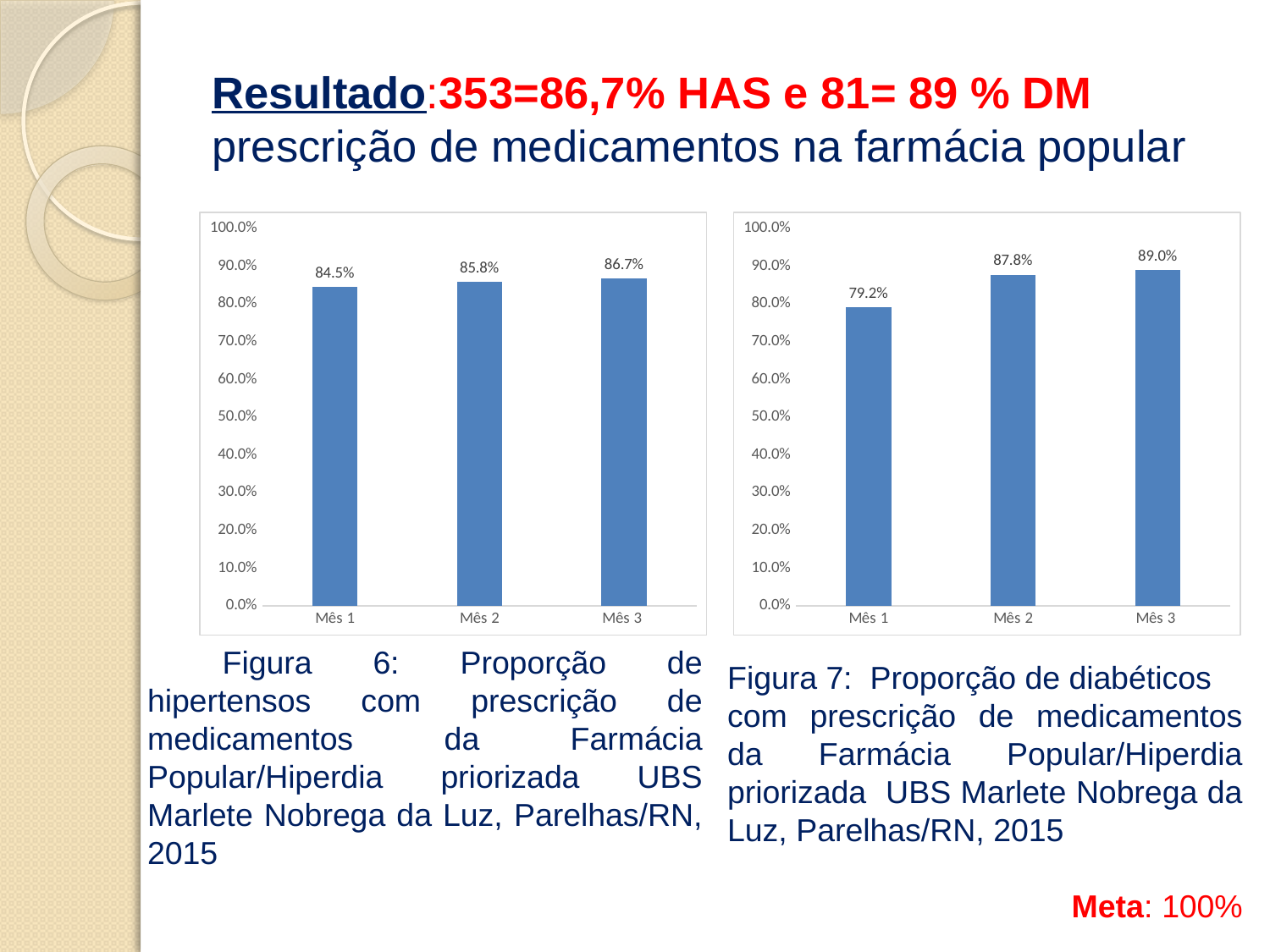
What kind of chart is the right chart (Figura 7, diabéticos)? bar chart In the left chart (Figura 6, hipertensos), what is the difference between Mês 3 and Mês 1? 2.2% In the right chart (Figura 7, diabéticos), what is the value for Mês 2? 87.8% In the right chart (Figura 7, diabéticos), what is the difference between Mês 2 and Mês 1? 8.6% In the left chart (Figura 6, hipertensos), what is the value for Mês 1? 84.5% In the left chart (Figura 6, hipertensos), do the values rise or fall from Mês 1 to Mês 3? rise In the right chart (Figura 7, diabéticos), which month has the lowest value? Mês 1 In the right chart (Figura 7, diabéticos), is the value for Mês 1 greater or less than 80.0%? less In the left chart (Figura 6, hipertensos), what is the value for Mês 3? 86.7% How many months are shown in the left chart (Figura 6, hipertensos)? 3 In the right chart (Figura 7, diabéticos), what is the value for Mês 1? 79.2% In the right chart (Figura 7, diabéticos), which month has the highest value? Mês 3